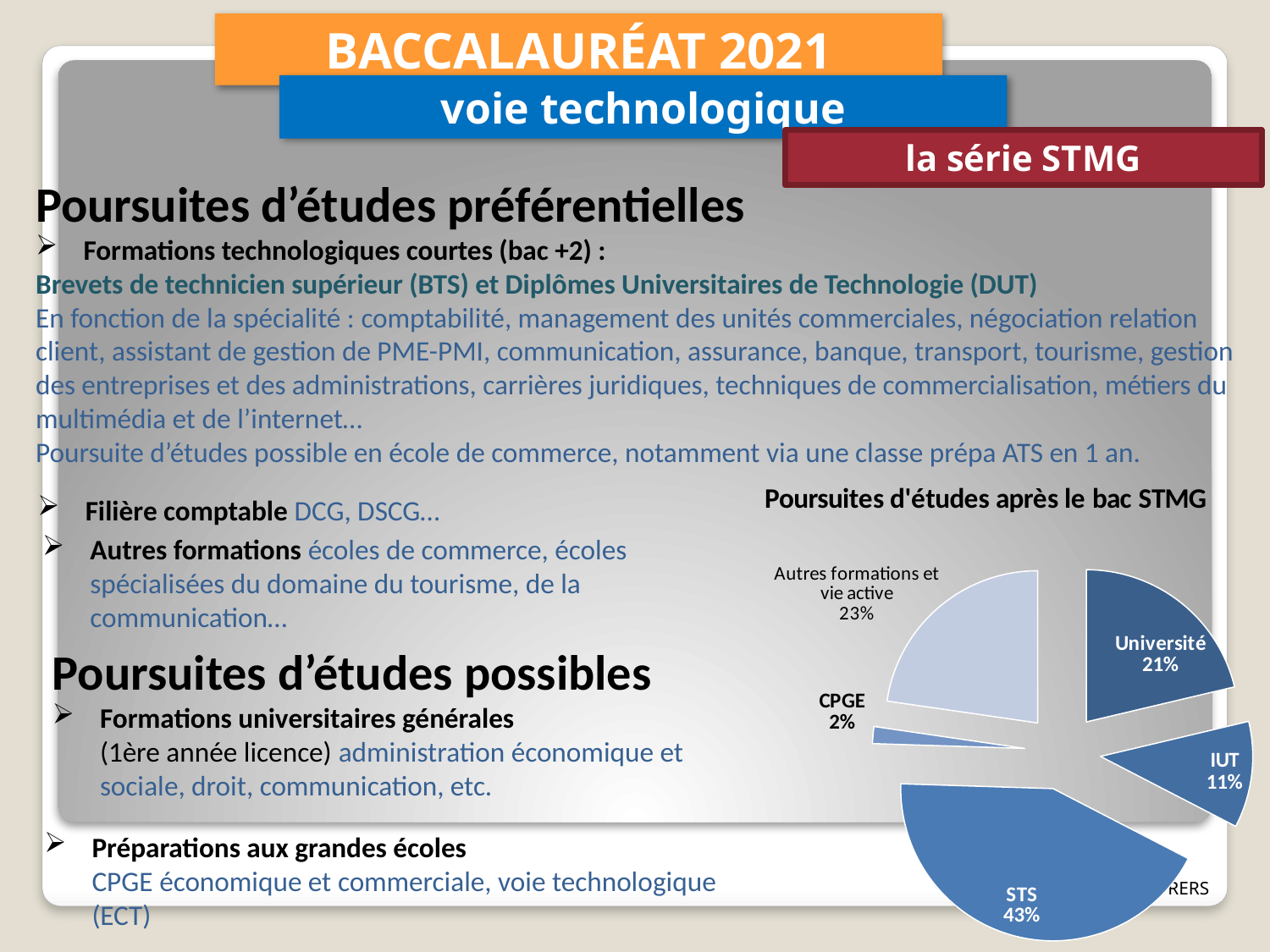
Which slice of the pie is the smallest? CPGE Which slice of the pie is the largest? STS What share of the pie does STS represent? 43% What share of the pie does 'Autres formations et vie active' represent? 23% What kind of chart is shown on the slide? pie chart What share of the pie does IUT represent? 11% Which is larger, the share for IUT or the share for Université? Université How many slices does the pie chart have? 5 What share of the pie does CPGE represent? 2% What share of the pie does Université represent? 21% What is the difference between the STS share and the Université share? 22% What is the title of the chart? Poursuites d'études après le bac STMG